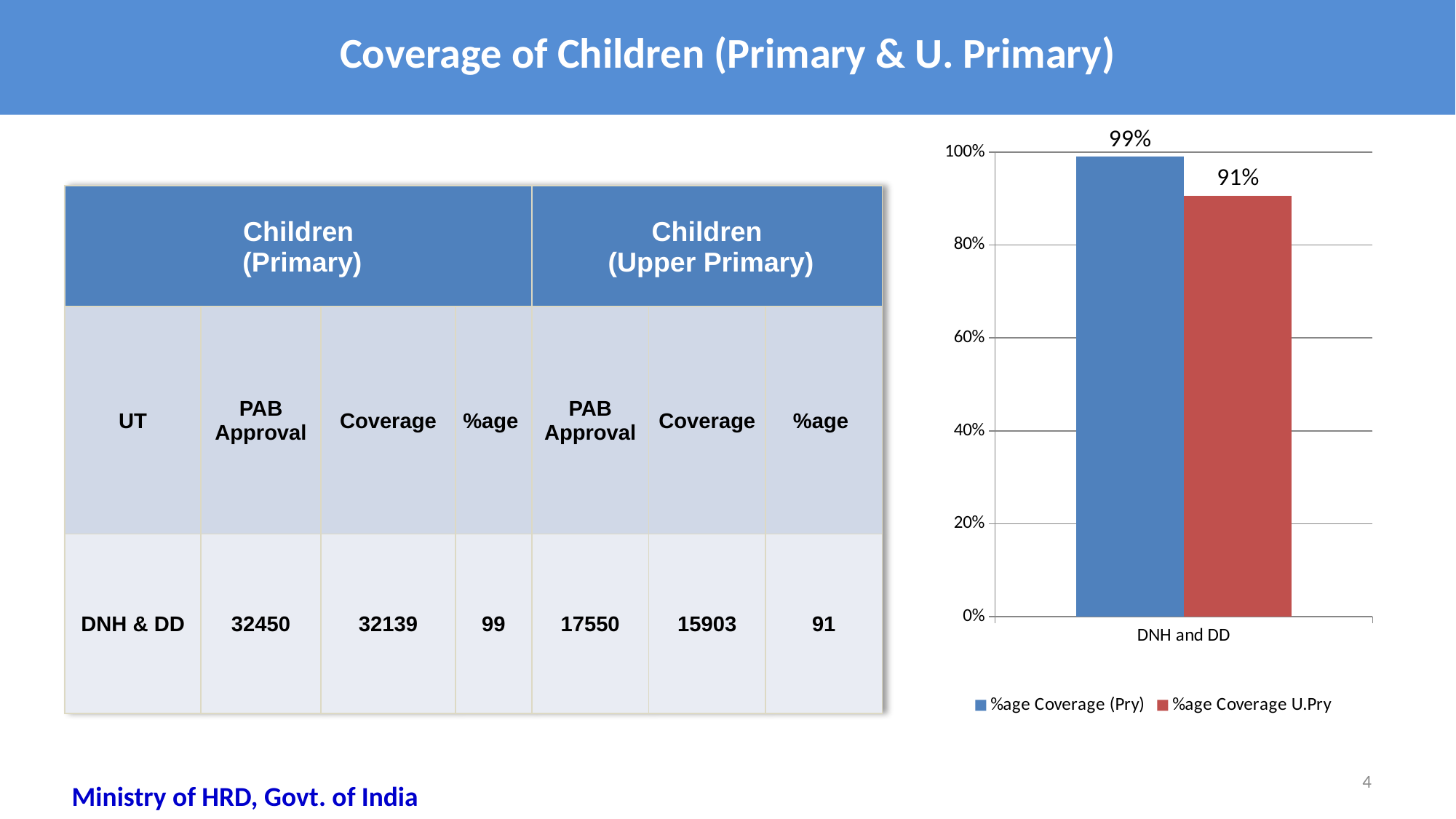
How many series does the chart legend list? 2 What kind of chart is shown on the slide? bar chart How many categories are shown on the x axis of the chart? 1 Is %age Coverage (Pry) or %age Coverage U.Pry larger for DNH and DD in the chart? %age Coverage (Pry) Which series has the lower value for DNH and DD in the chart? %age Coverage U.Pry Which series has the higher value for DNH and DD in the chart? %age Coverage (Pry) What is the value of %age Coverage (Pry) for DNH and DD in the chart? 99% What is the value of %age Coverage U.Pry for DNH and DD in the chart? 91% What is the category label on the x axis of the chart? DNH and DD Is the value for %age Coverage U.Pry greater or less than 80%? greater What is the difference between %age Coverage (Pry) and %age Coverage U.Pry for DNH and DD in the chart? 8% What colour is the bar for %age Coverage U.Pry in the chart? red